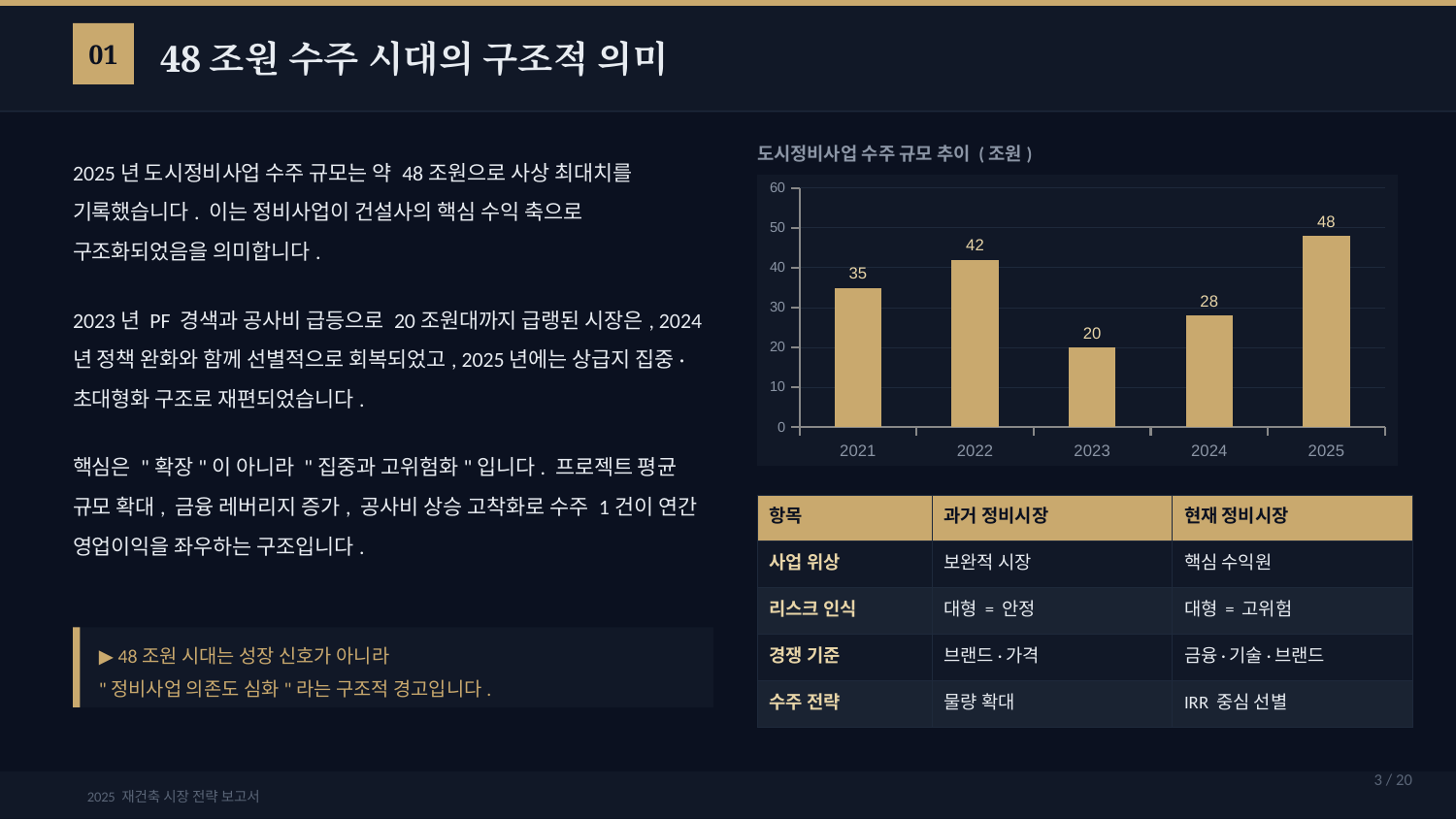
Is the value for 2024 greater or less than 30? less What is the value for 2023 in the chart? 20 What is the value for 2025 in the chart? 48 Which year has the lowest value in the chart? 2023 What is the title of the chart? 도시정비사업 수주 규모 추이 (조원) What kind of chart is shown on the slide? bar chart What is the difference between the values for 2022 and 2023? 22 Which is larger, the value for 2022 or the value for 2024? 2022 Which year has the highest value in the chart? 2025 What is the difference between the values for 2025 and 2024? 20 What is the value for 2021 in the chart? 35 How many years are shown on the x axis of the chart? 5